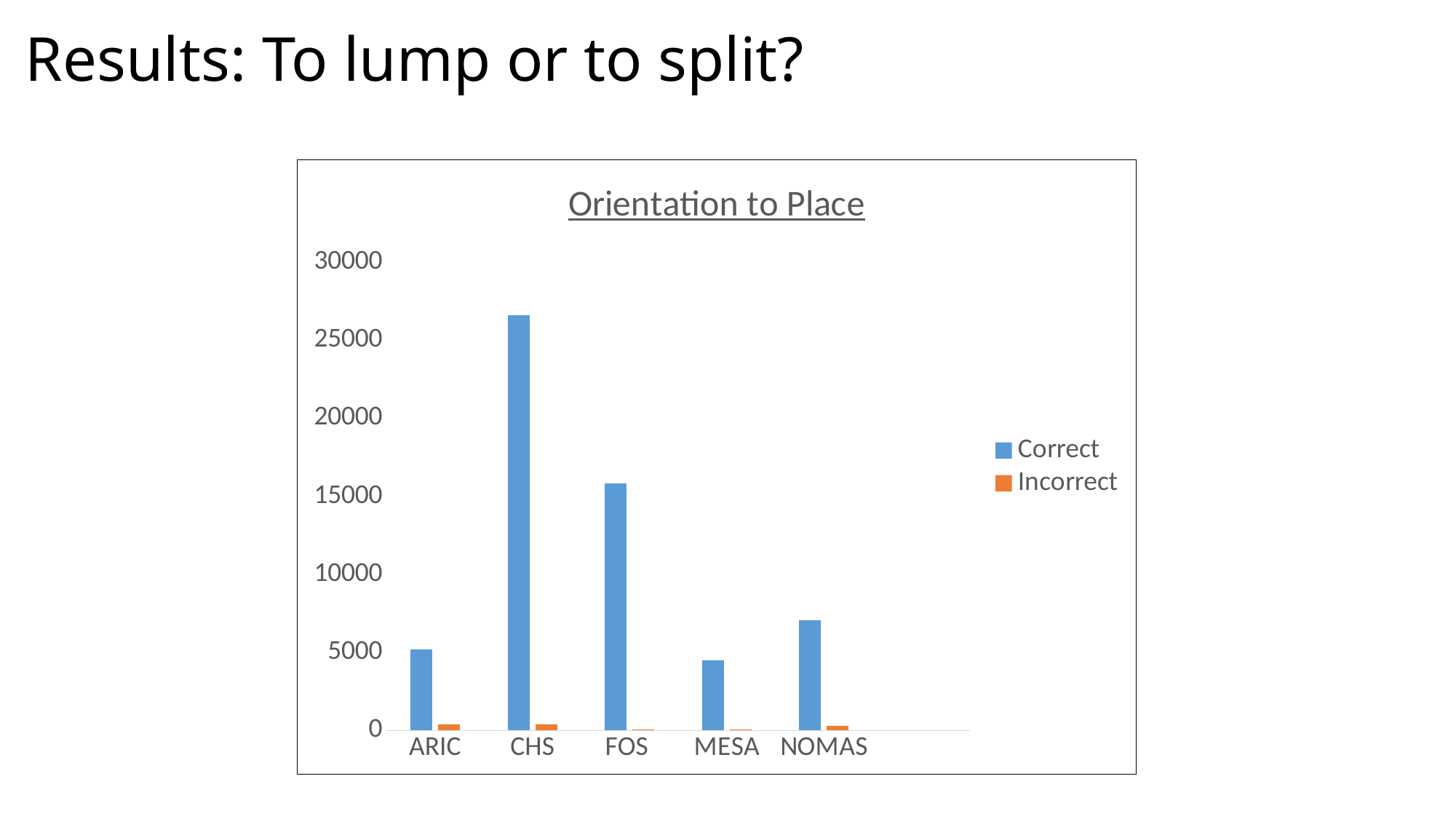
Which colour represents the Incorrect series in the chart? orange Which category has the highest Correct value? CHS How many series does the legend list? 2 What kind of chart is shown on the slide? bar chart Which is larger, the Correct value for FOS or the Correct value for NOMAS? FOS Is the Correct value for NOMAS greater or less than 5000? greater Which category has the lowest Correct value? MESA Is the Correct value for CHS greater or less than 25000? greater How many categories are shown on the x axis of the chart? 5 Is the Correct value for FOS greater or less than 20000? less What is the title of the chart? Orientation to Place Which is larger for ARIC, the Correct value or the Incorrect value? Correct